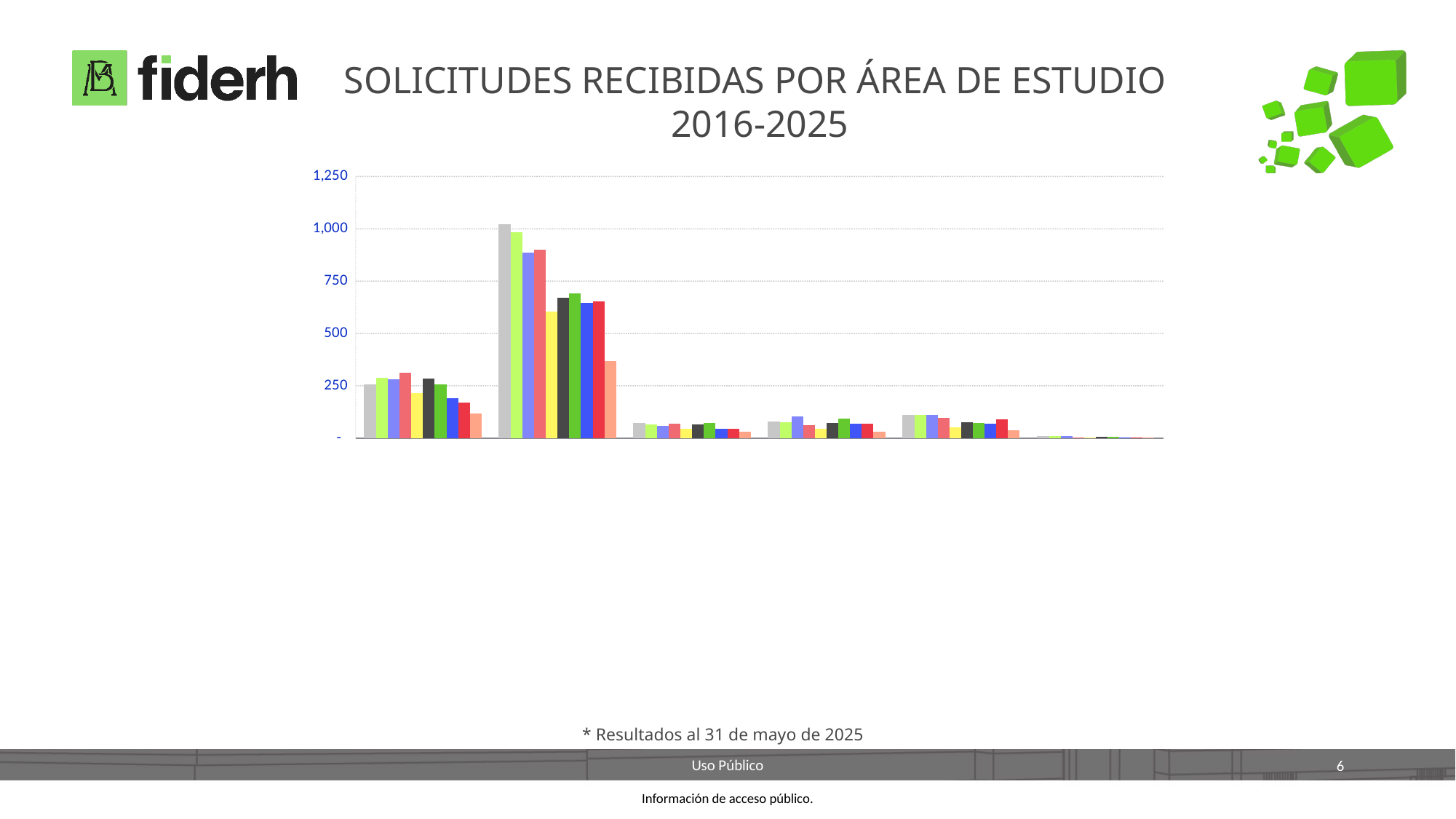
Are the bars in the third group from the left greater or less than 250? less What is the highest value labelled on the y axis of the chart? 1,250 Is the tallest bar in the second group from the left greater or less than 750? greater What kind of chart is shown on the slide? bar chart What is the title of the chart on the slide? SOLICITUDES RECIBIDAS POR ÁREA DE ESTUDIO 2016-2025 How many groups of bars are plotted along the x axis of the chart? 6 Which group of bars contains the tallest bar in the chart? the second group from the left Which group of bars has the smallest bars in the chart? the rightmost (sixth) group Which has the taller tallest bar: the first group from the left or the second group from the left? the second group from the left Is the tallest bar in the first (leftmost) group greater or less than 500? less How many bars are there in each group of the chart? 10